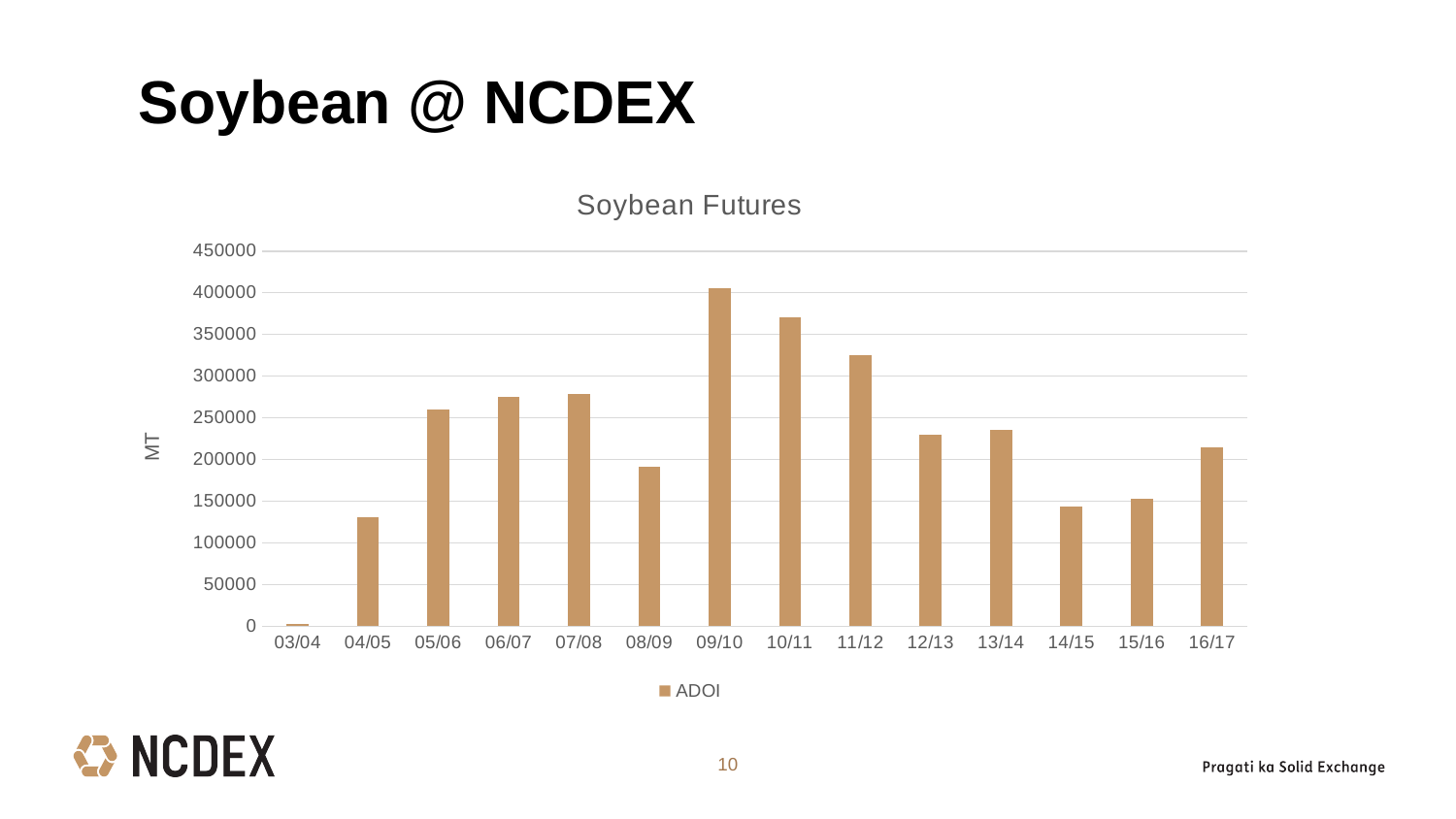
How many years are shown on the x axis of the Soybean Futures chart? 14 Which year has the lowest ADOI value in the Soybean Futures chart? 03/04 What is the label on the vertical axis of the Soybean Futures chart? MT Is the ADOI value for 11/12 greater or less than 300000? greater Do the ADOI values rise or fall from 09/10 to 14/15? fall Is the ADOI value for 08/09 greater or less than 200000? less What type of chart is shown on the slide? Bar chart Which year has the highest ADOI value in the Soybean Futures chart? 09/10 How many series does the legend of the Soybean Futures chart list? 1 Is the ADOI value for 04/05 greater or less than 150000? less Which year has a larger ADOI value, 10/11 or 11/12? 10/11